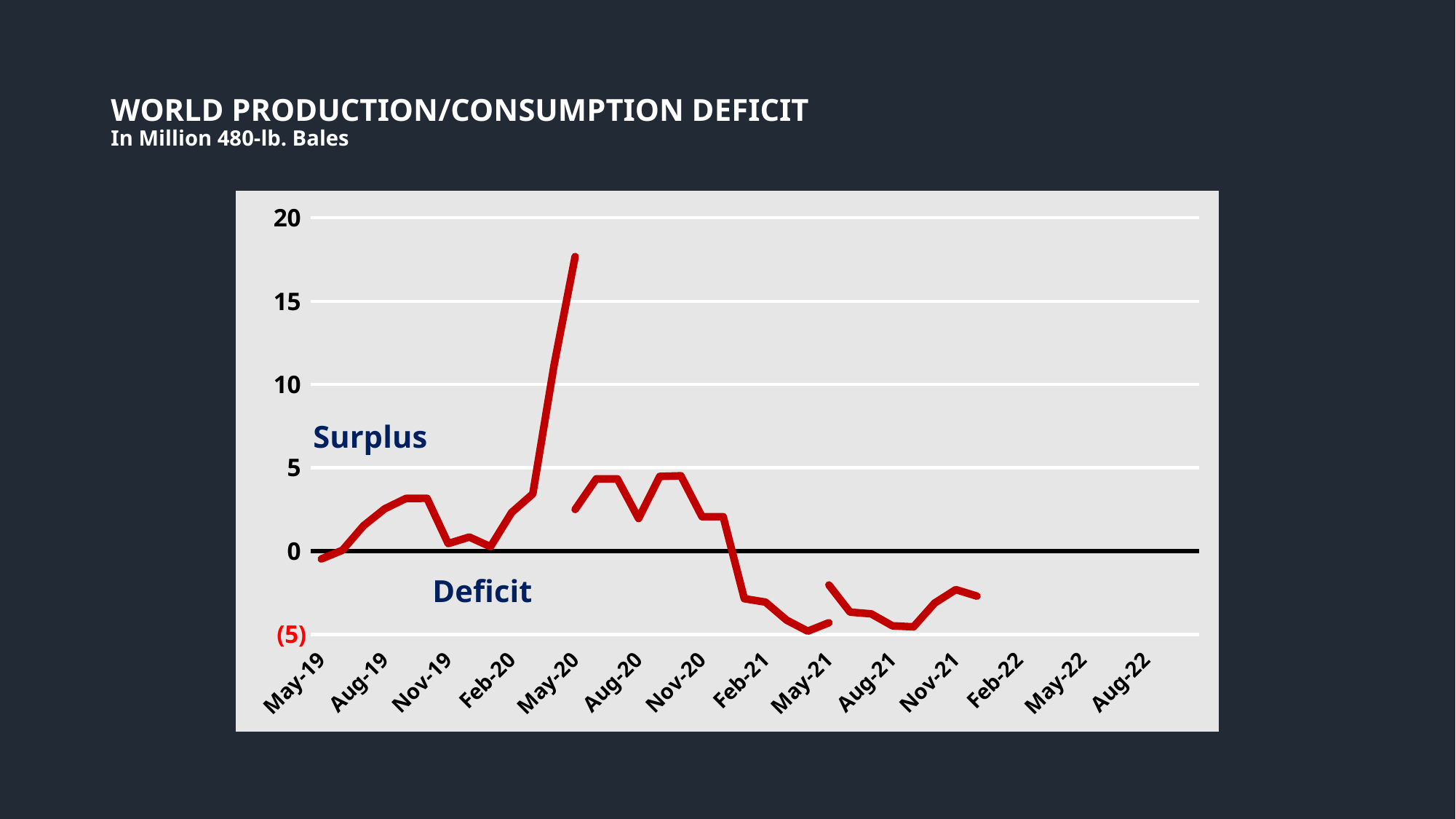
Is the value for Aug-20 greater or less than 5? less At which month does the line reach its highest value? May-20 Do the values rise or fall from Nov-20 to Feb-21? fall Is the value for Feb-21 greater or less than 0? less Which is larger, the value for May-20 or the value for Aug-20? May-20 Is the value for May-20 greater or less than 15? greater How many month labels are shown on the x axis? 14 In what units are the values on the chart expressed? Million 480-lb. Bales Which is larger, the value for Nov-20 or the value for Feb-21? Nov-20 What is the title of the chart? WORLD PRODUCTION/CONSUMPTION DEFICIT What kind of chart is shown on the slide? line chart